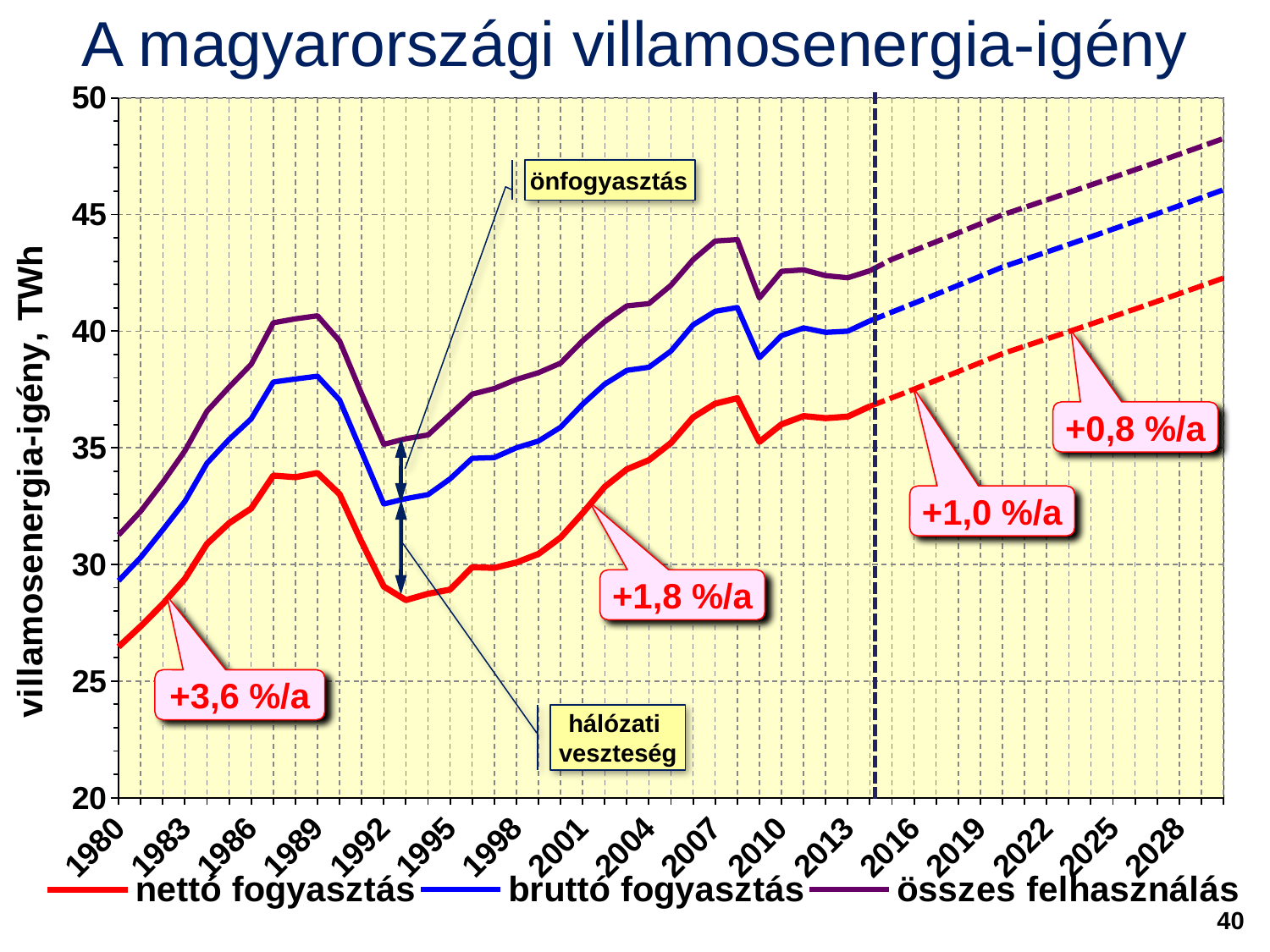
What annual growth rate is annotated on the nettó fogyasztás line for the early 1980s? +3,6 %/a Is the value of nettó fogyasztás in 1980 greater or less than 30? less What annual growth rate is annotated on the dashed nettó fogyasztás line near 2025? +0,8 %/a What is the title of the chart? A magyarországi villamosenergia-igény Between 1989 and 1993, does nettó fogyasztás rise or fall? fall What is the label of the vertical axis? villamosenergia-igény, TWh Which series has the lowest values across the whole chart? nettó fogyasztás What kind of chart is shown on the slide? line chart Is the value of összes felhasználás in 2008 greater or less than 40? greater How many series does the legend list? 3 Is the value of bruttó fogyasztás in 1993 greater or less than 35? less Which series has the highest values across the whole chart? összes felhasználás